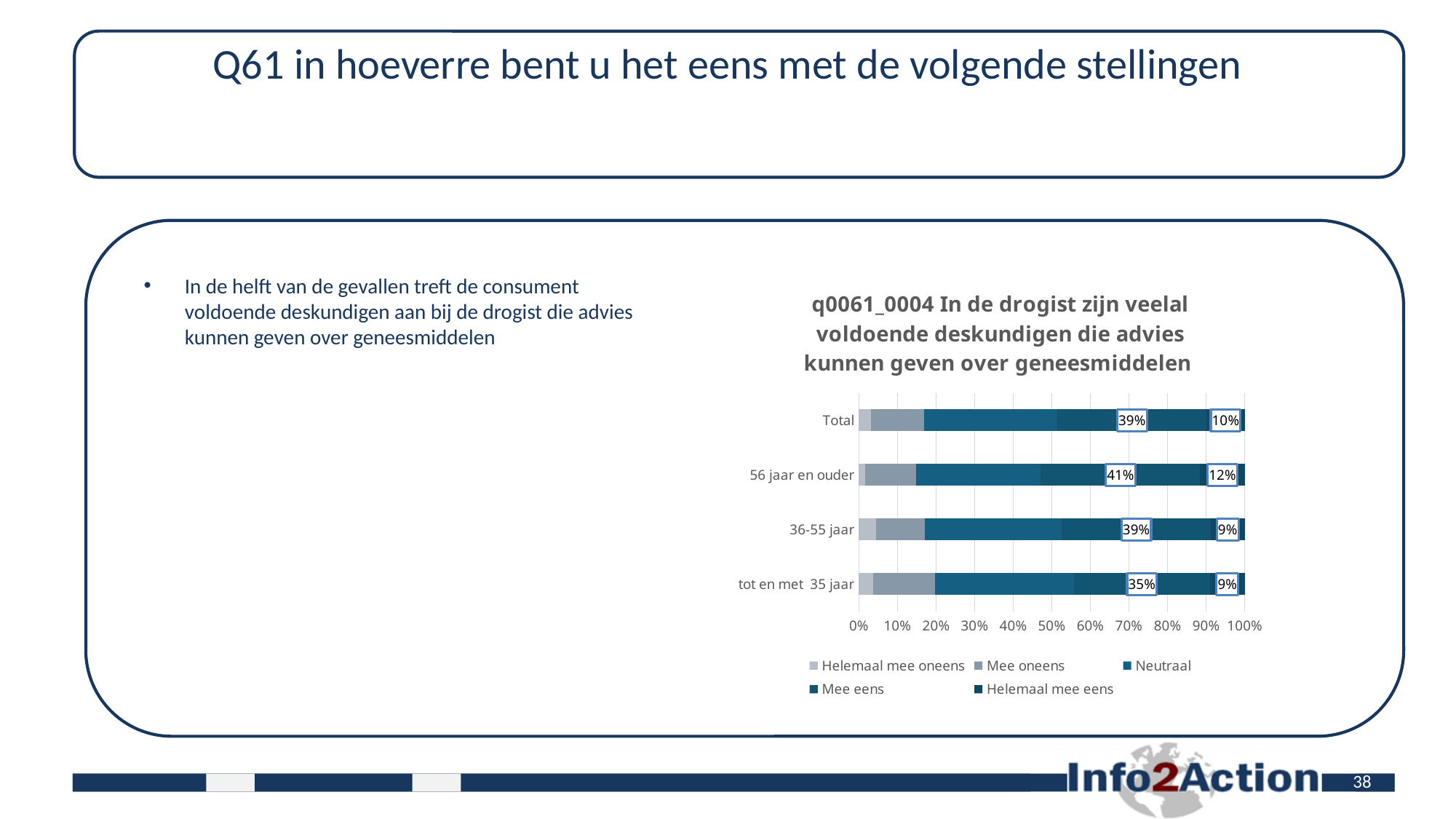
What is the value for "Helemaal mee eens" in the "36-55 jaar" bar? 9% Which category has the lowest value for "Mee eens"? tot en met 35 jaar What is the value for "Helemaal mee eens" in the "Total" bar? 10% How many categories (bars) are shown in the chart? 4 Is the value for "Helemaal mee oneens" in the "Total" bar greater or less than 10%? less What is the value for "Mee eens" in the "tot en met 35 jaar" bar? 35% Which is larger: "Helemaal mee eens" for "56 jaar en ouder" or for "Total"? 56 jaar en ouder Which category has the highest value for "Mee eens"? 56 jaar en ouder What kind of chart is shown on the slide? Stacked bar chart What is the difference in "Mee eens" between "56 jaar en ouder" and "tot en met 35 jaar"? 6 percentage points How many series does the legend list? 5 What is the value for "Mee eens" in the "56 jaar en ouder" bar? 41%